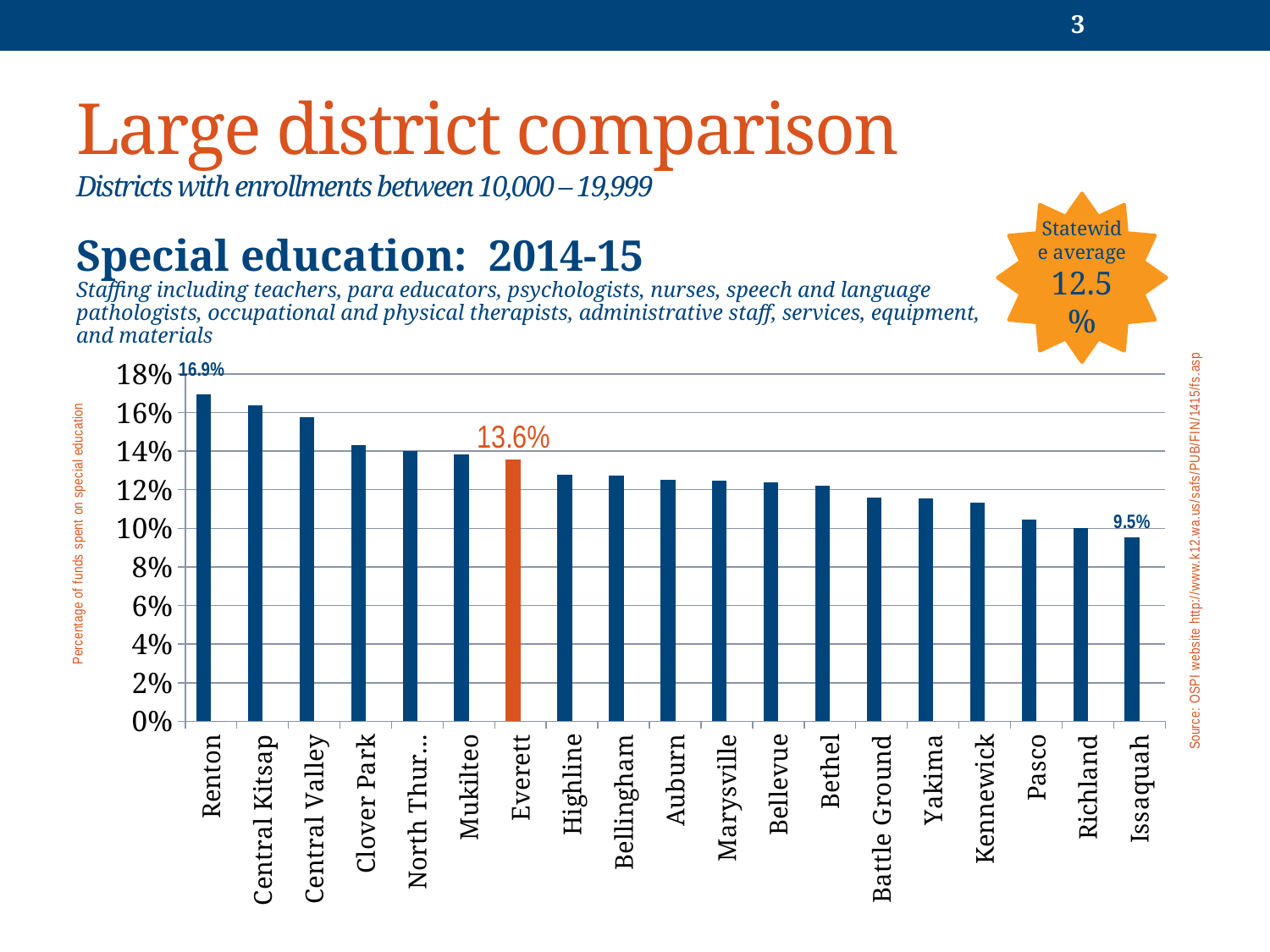
What is the value for Renton? 16.9% Which is larger, the value for Central Kitsap or the value for Pasco? Central Kitsap Is the value for Kennewick greater or less than 12%? less How many districts are shown on the chart? 19 Which district has the highest percentage of funds spent on special education? Renton What is the difference between the values for Renton and Issaquah? 7.4% Is the value for Central Valley greater or less than 14%? greater Which district has the lowest percentage of funds spent on special education? Issaquah What kind of chart is shown on the slide? bar chart What is the value for Everett? 13.6% What is the difference between the values for Renton and Everett? 3.3% What is the value for Issaquah? 9.5%